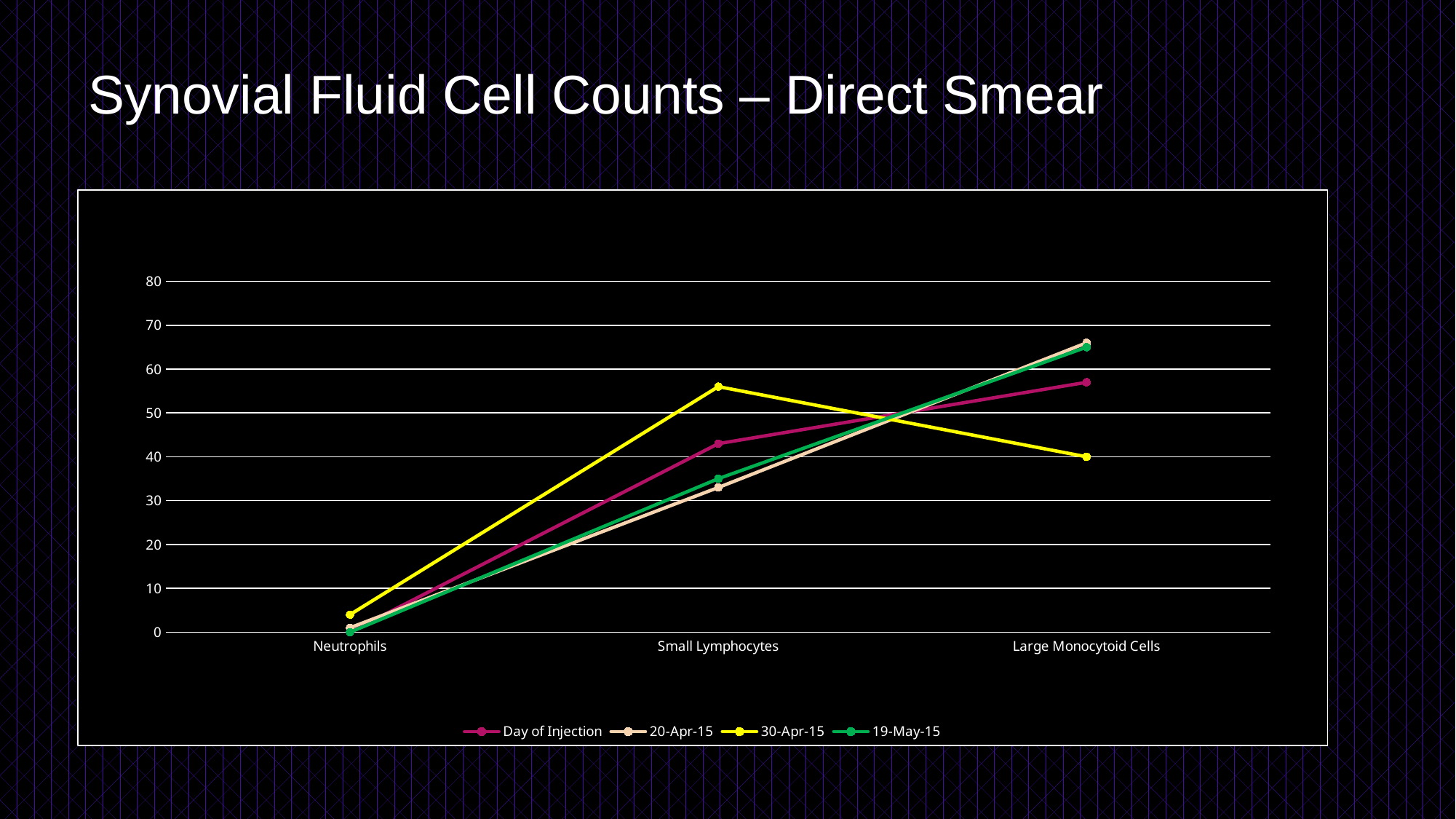
Is the value for Small Lymphocytes in the 20-Apr-15 series greater or less than 40? less Is the value for Small Lymphocytes in the 30-Apr-15 series greater or less than 50? greater How many categories are shown on the x axis? 3 What kind of chart is shown on the slide? line chart What is the value for Large Monocytoid Cells in the 30-Apr-15 series? 40 Is the value for Large Monocytoid Cells in the Day of Injection series greater or less than 60? less Do the values in the 20-Apr-15 series rise or fall from Neutrophils to Large Monocytoid Cells? rise For Large Monocytoid Cells, which is larger: the Day of Injection value or the 30-Apr-15 value? Day of Injection Which series has the highest value for Small Lymphocytes? 30-Apr-15 How many series does the legend list? 4 What is the value for Neutrophils in the Day of Injection series? 0 Which series has the lowest value for Large Monocytoid Cells? 30-Apr-15